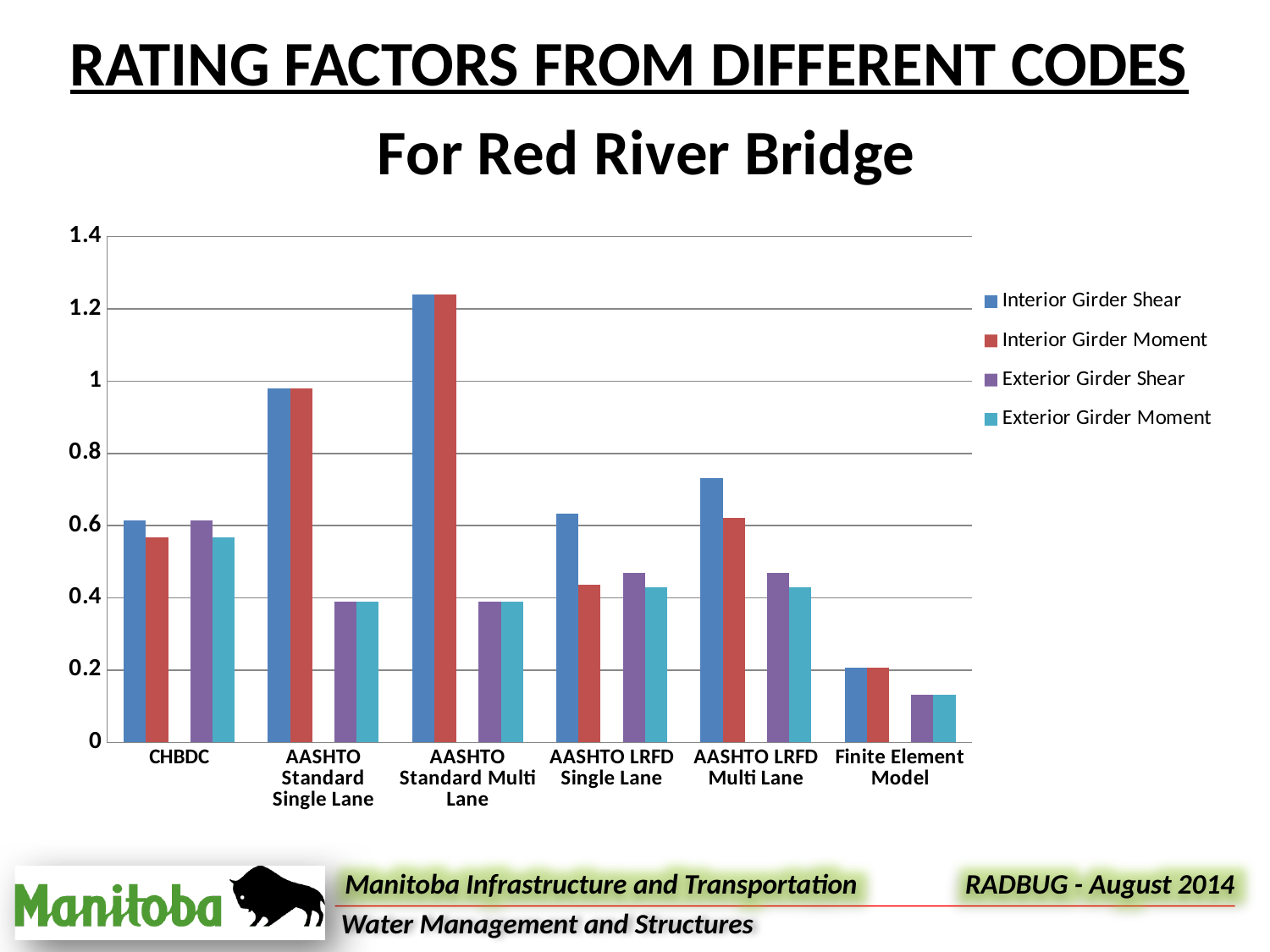
Is the Interior Girder Shear value for AASHTO Standard Multi Lane greater or less than 1? greater For CHBDC, which is larger: Interior Girder Shear or Interior Girder Moment? Interior Girder Shear Which category has the lowest Interior Girder Shear rating factor? Finite Element Model What kind of chart is shown on the slide? Bar chart Which series is shown in red in the legend? Interior Girder Moment How many series does the legend list? 4 Is the Exterior Girder Shear value for AASHTO Standard Single Lane greater or less than 0.6? less Which has the larger Interior Girder Shear value: AASHTO LRFD Single Lane or AASHTO LRFD Multi Lane? AASHTO LRFD Multi Lane Which category has the highest Exterior Girder Shear rating factor? CHBDC Is the Interior Girder Moment value for Finite Element Model greater or less than 0.4? less How many categories (codes) are shown along the x axis? 6 Which category has the highest Interior Girder Shear rating factor? AASHTO Standard Multi Lane